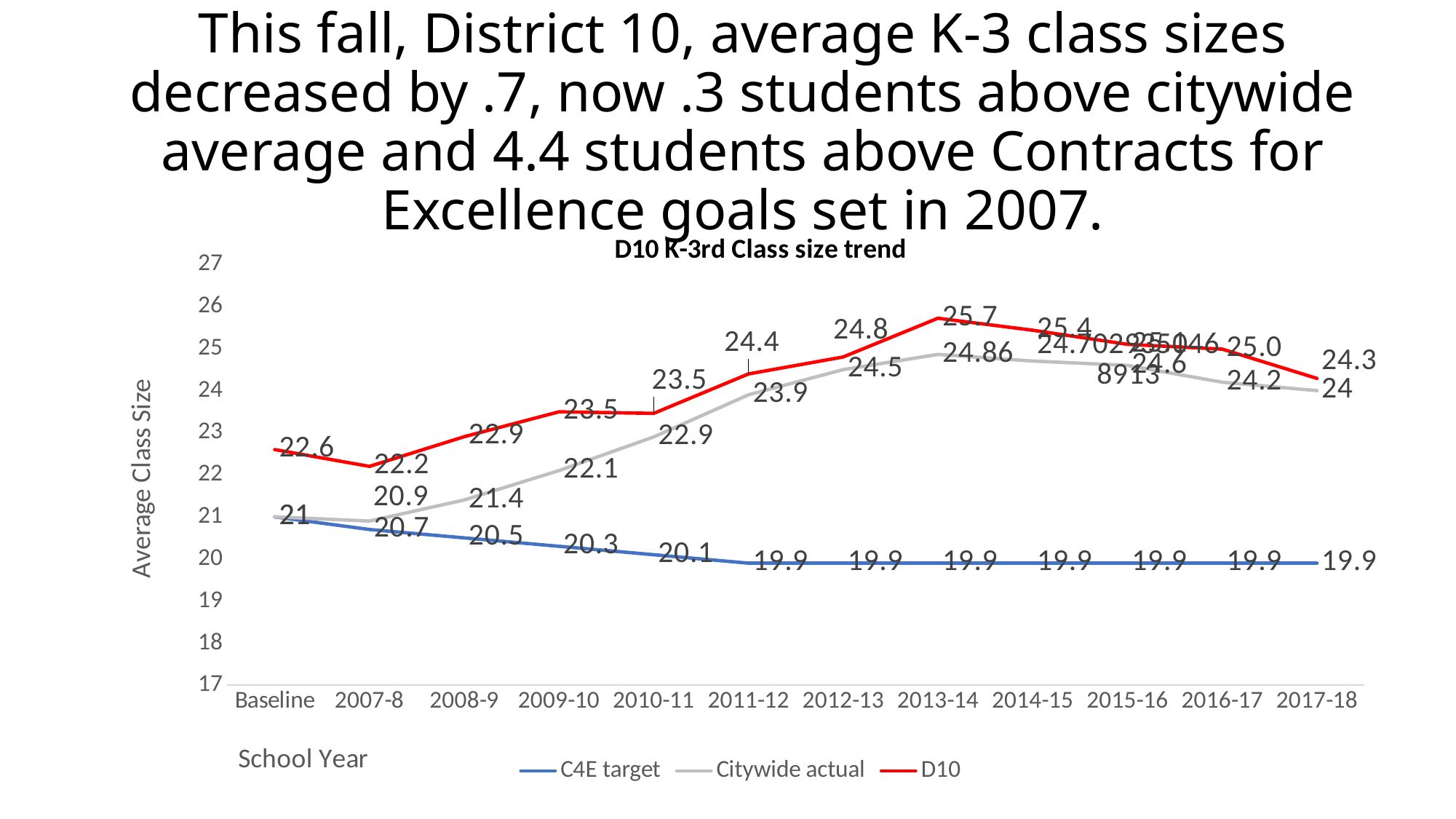
Does the C4E target series rise or fall from Baseline to 2011-12? Fall What kind of chart is shown on the slide? Line chart What is the D10 value for 2013-14? 25.7 Which is larger, the D10 value for 2012-13 or for 2011-12? 2012-13 In which school year is the D10 value lowest? 2007-8 In which school year is the D10 value highest? 2013-14 What is the Citywide actual value for 2011-12? 23.9 What is the D10 value for 2007-8? 22.2 How many school-year categories are shown on the x axis? 12 What is the difference between the D10 value and the Citywide actual value in 2017-18? 0.3 How many series does the legend list? 3 What is the C4E target value for 2017-18? 19.9